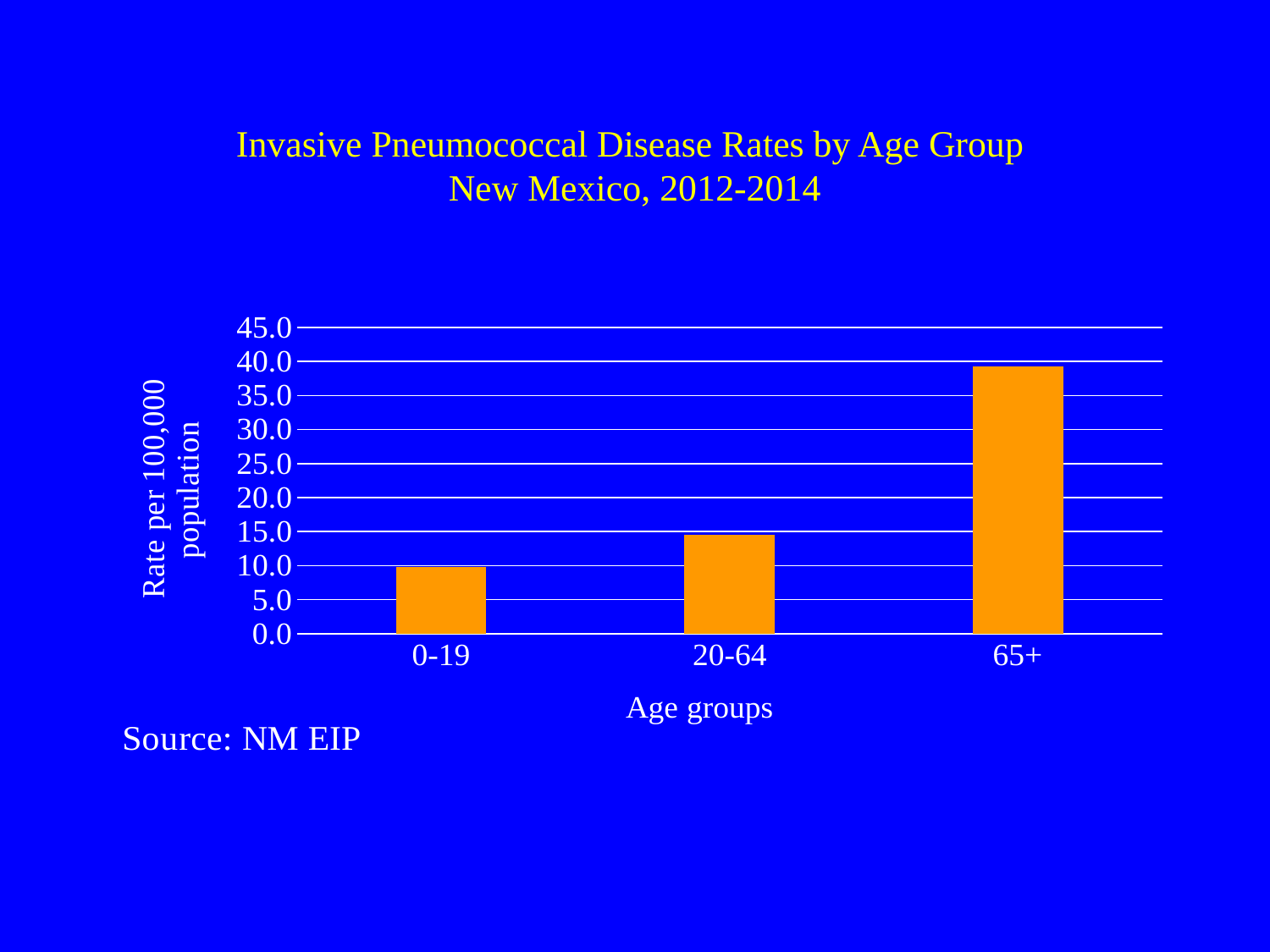
Which age group has a higher rate, 20-64 or 65+? 65+ What kind of chart is shown on the slide? bar chart Is the value for the 20-64 age group greater or less than 10.0? greater Is the value for the 0-19 age group greater or less than 15.0? less Which age group has the highest invasive pneumococcal disease rate? 65+ What is the label of the y axis? Rate per 100,000 population Which age group has the lowest invasive pneumococcal disease rate? 0-19 Is the value for the 20-64 age group greater or less than 20.0? less Do the rates rise or fall as age group increases along the x axis? rise How many age groups are shown on the x axis? 3 Which age group has a higher rate, 0-19 or 20-64? 20-64